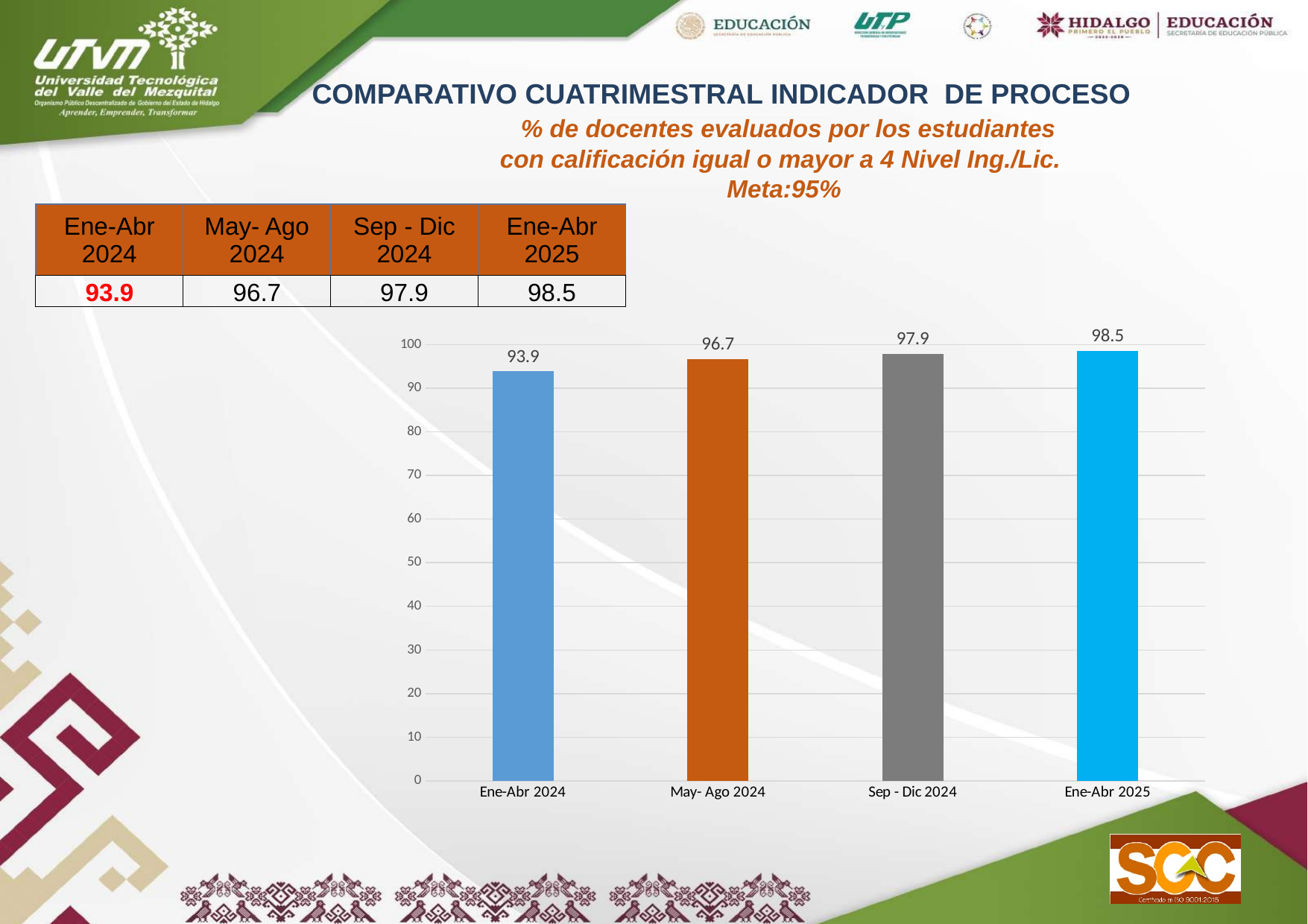
What is the value for Sep - Dic 2024? 97.9 Which period has the lowest value? Ene-Abr 2024 What is the difference between the values for Ene-Abr 2025 and Ene-Abr 2024? 4.6 What is the value for Ene-Abr 2024? 93.9 Is the value for Ene-Abr 2024 greater or less than 90? greater What is the difference between the values for Sep - Dic 2024 and May- Ago 2024? 1.2 What is the value for Ene-Abr 2025? 98.5 Which period has the highest value? Ene-Abr 2025 What kind of chart is shown on the slide? bar chart How many periods are shown in the chart? 4 Do the values rise or fall from Ene-Abr 2024 to Ene-Abr 2025? rise Which is larger, the value for May- Ago 2024 or the value for Ene-Abr 2024? May- Ago 2024